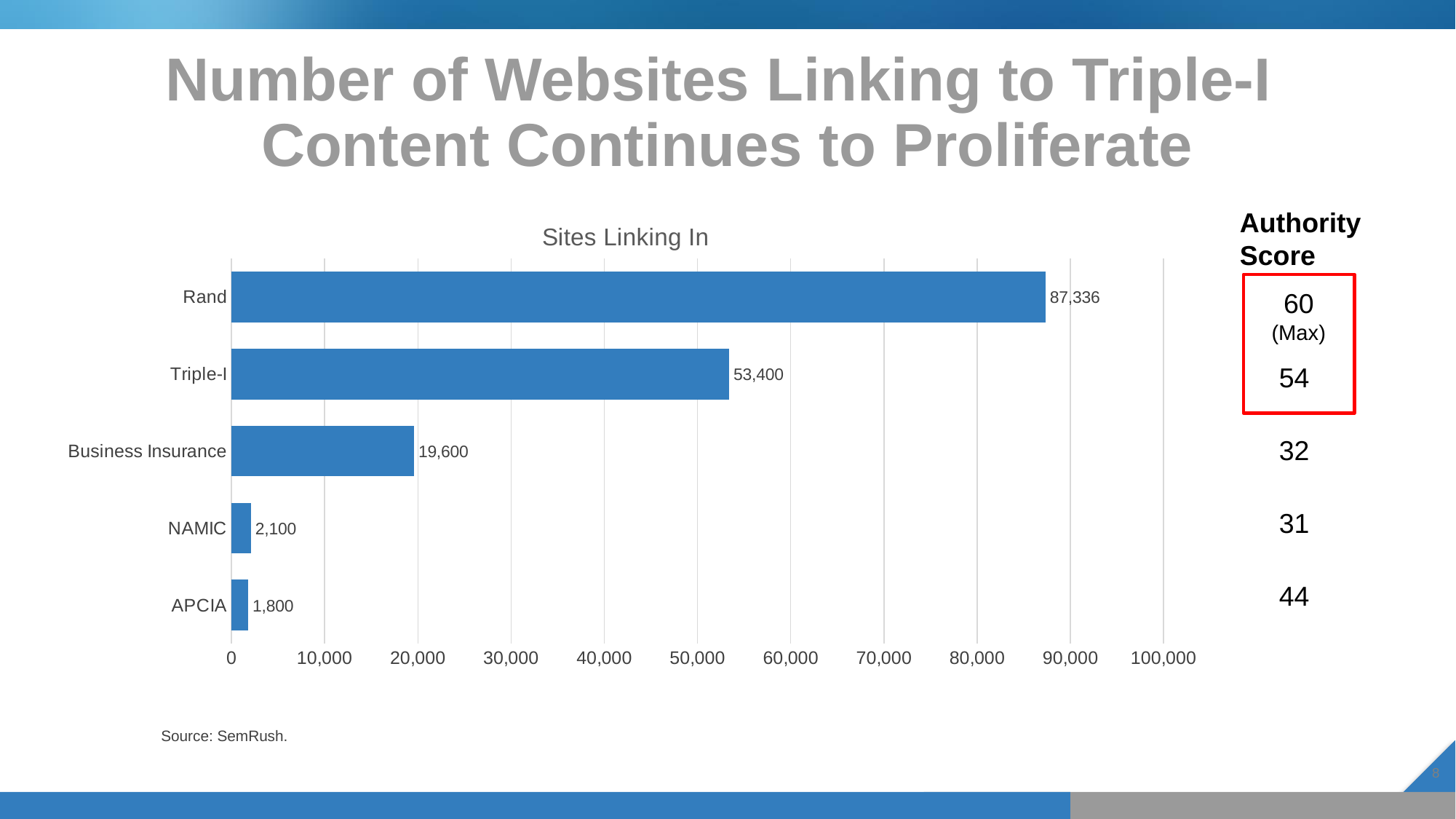
What type of chart is the Sites Linking In chart? bar chart What is the value for Rand in the Sites Linking In chart? 87,336 What is the value for APCIA in the Sites Linking In chart? 1,800 What is the difference between the values for Rand and Triple-I in the Sites Linking In chart? 33,936 Which category has the lowest value in the Sites Linking In chart? APCIA What is the value for Business Insurance in the Sites Linking In chart? 19,600 What is the difference between the values for NAMIC and APCIA in the Sites Linking In chart? 300 How many categories are shown in the Sites Linking In chart? 5 Is the value for Triple-I in the Sites Linking In chart greater or less than 50,000? greater What is the value for Triple-I in the Sites Linking In chart? 53,400 Which category has the highest value in the Sites Linking In chart? Rand Which is larger in the Sites Linking In chart, the value for Business Insurance or the value for NAMIC? Business Insurance